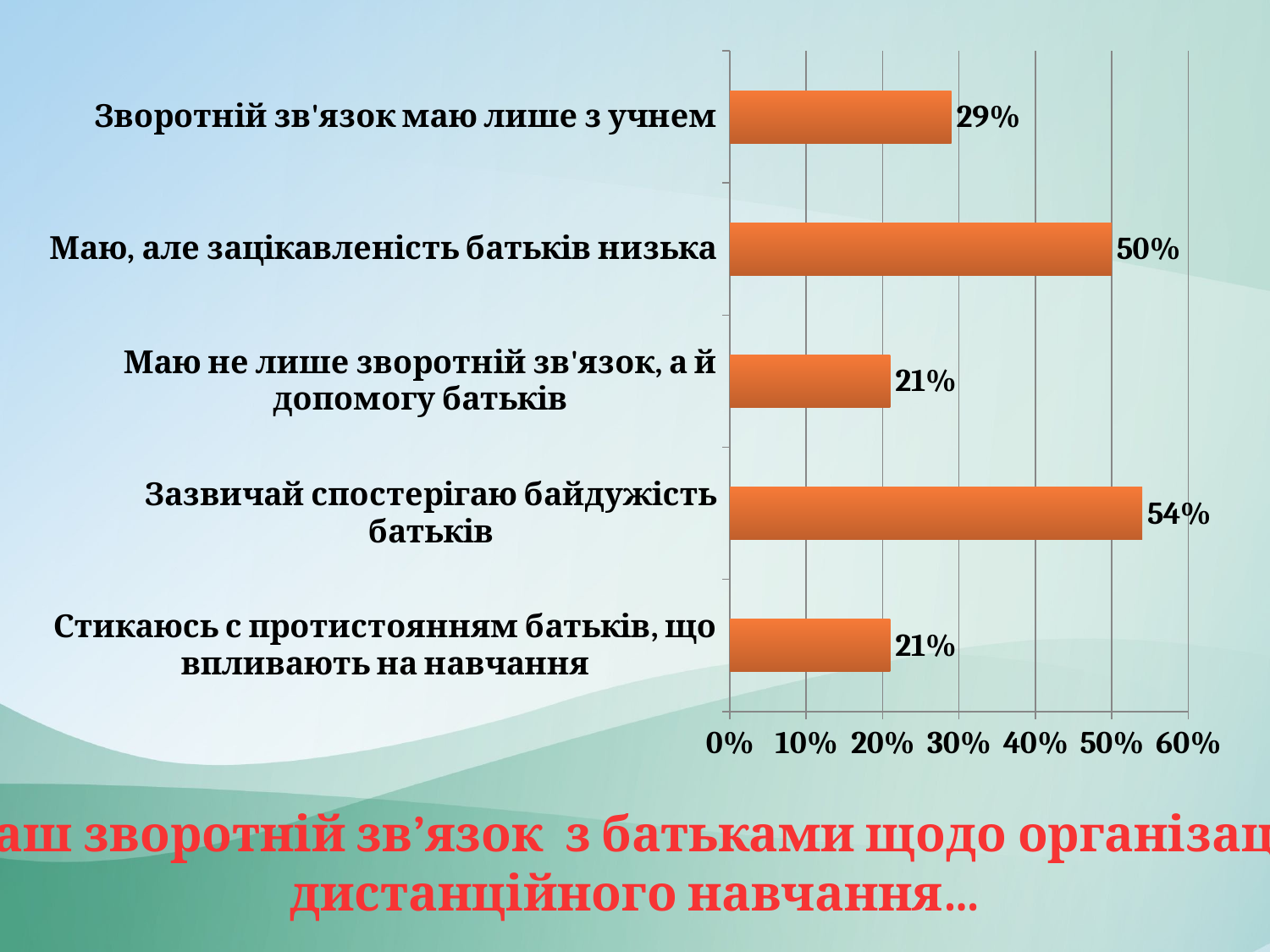
What is the value for "Маю не лише зворотній зв'язок, а й допомогу батьків"? 21% Which category has the highest value? Зазвичай спостерігаю байдужість батьків What is the value for "Зазвичай спостерігаю байдужість батьків"? 54% Is the value for "Зазвичай спостерігаю байдужість батьків" greater or less than 50%? greater What is the difference between the values for "Зазвичай спостерігаю байдужість батьків" and "Маю, але зацікавленість батьків низька"? 4% What colour are the bars in the chart? orange What is the value for "Зворотній зв'язок маю лише з учнем"? 29% What is the difference between the values for "Маю, але зацікавленість батьків низька" and "Зворотній зв'язок маю лише з учнем"? 21% What is the value for "Маю, але зацікавленість батьків низька"? 50% What kind of chart is shown on the slide? bar chart How many categories are shown in the chart? 5 Which is larger: the value for "Зворотній зв'язок маю лише з учнем" or the value for "Стикаюсь с протистоянням батьків, що впливають на навчання"? Зворотній зв'язок маю лише з учнем